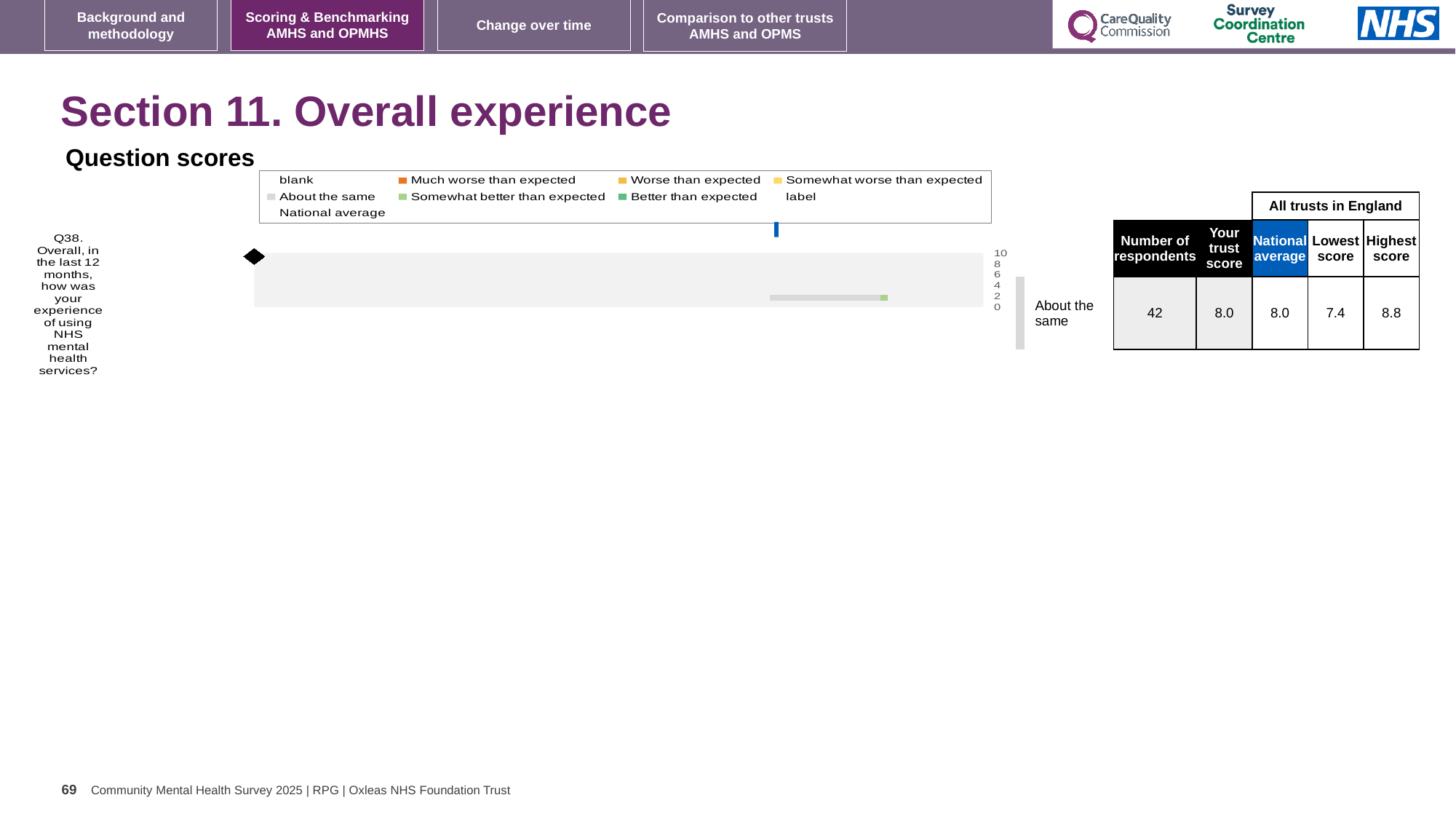
Is the trust score for Q38 greater or less than 6 on the chart's axis? greater What is the difference between the highest score and the lowest score for Q38? 1.4 What is the trust score for Q38 (Overall, in the last 12 months, how was your experience of using NHS mental health services?)? 8.0 How many respondents answered Q38? 42 What kind of chart is shown under 'Question scores'? bar chart What is the national average score for Q38? 8.0 How many questions are plotted in the Question scores chart? 1 What is the maximum value shown on the chart's score axis? 10 Which benchmark category is Q38 assigned to on the slide? About the same What is the highest score among all trusts in England for Q38? 8.8 What is the lowest score among all trusts in England for Q38? 7.4 Is the trust score for Q38 higher than, lower than, or the same as the national average? the same